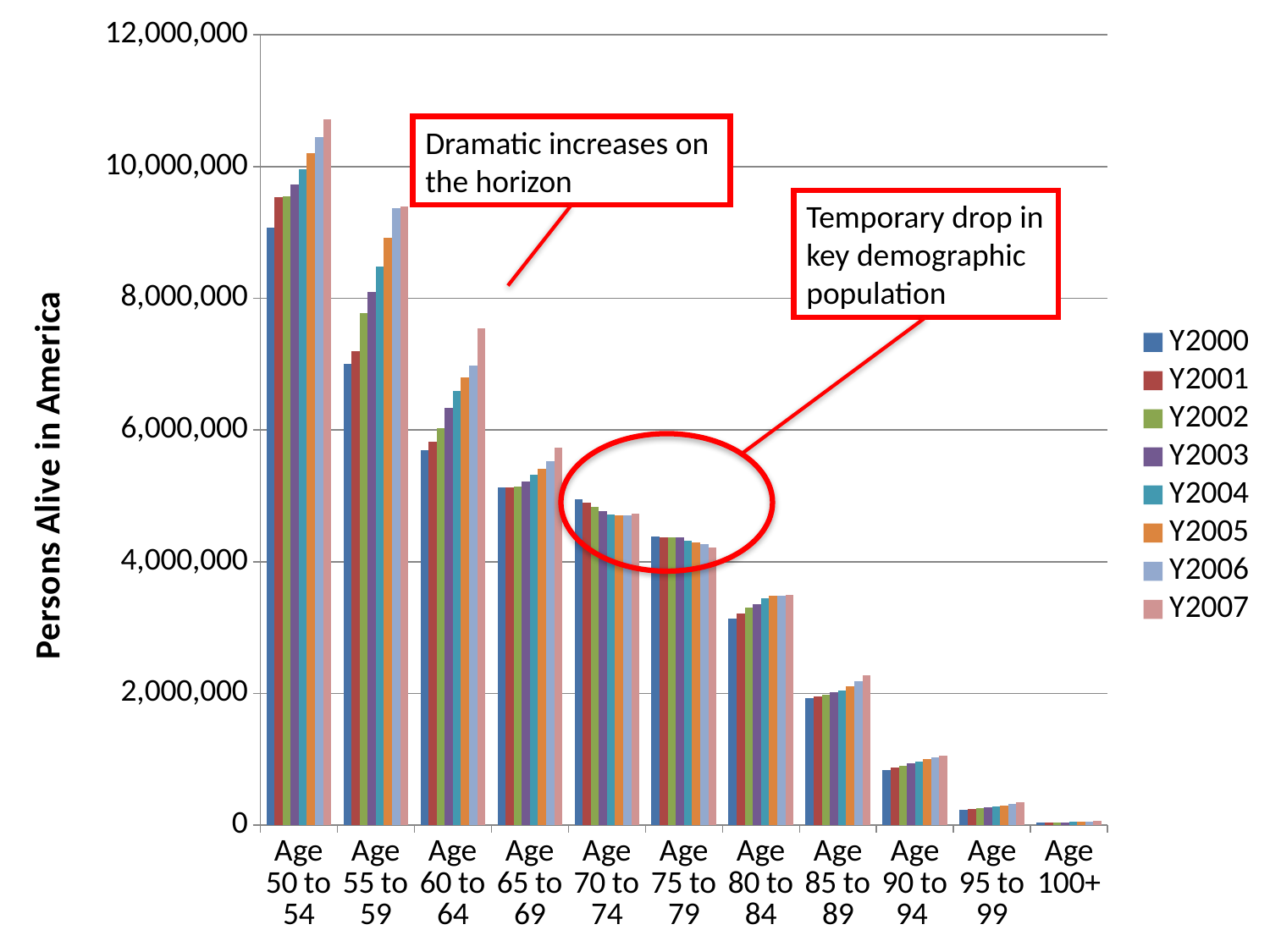
What kind of chart is shown on the slide? bar chart How many series does the legend list? 8 How many age categories are shown along the x axis? 11 Within the Age 50 to 54 category, which series has the highest value? Y2007 Which is larger: the Y2007 value for Age 65 to 69 or the Y2007 value for Age 70 to 74? Age 65 to 69 Do the values generally rise or fall moving from Age 50 to 54 toward Age 100+ along the x axis? fall Which age category has the lowest values? Age 100+ Is the Y2007 value for Age 50 to 54 greater or less than 10,000,000? greater Is the Y2000 value for Age 80 to 84 greater or less than 2,000,000? greater What is the title of the vertical axis? Persons Alive in America Which age category has the tallest bars overall? Age 50 to 54 Is the Y2000 value for Age 55 to 59 greater or less than 8,000,000? less